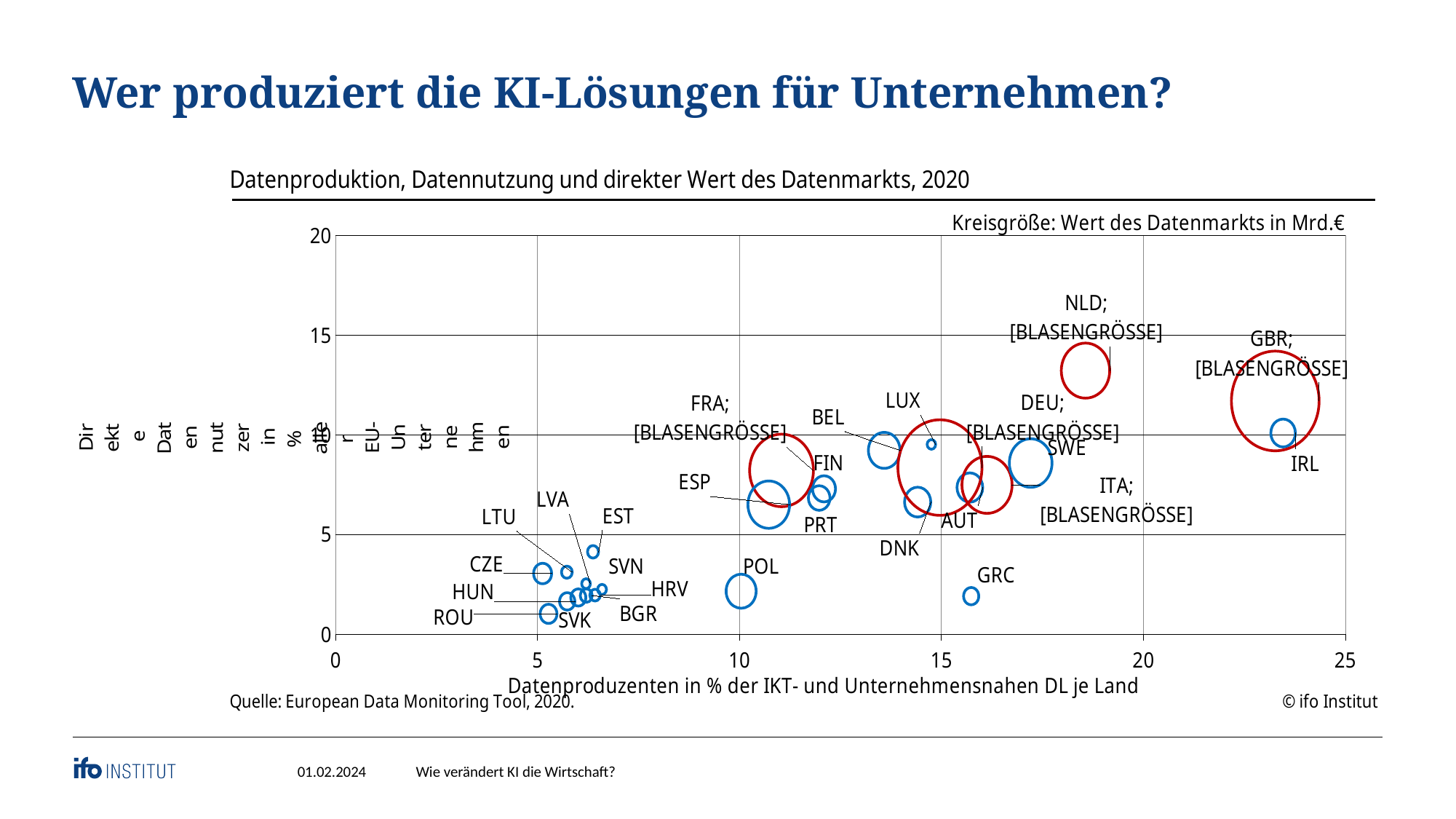
Is the x-axis value for BEL greater or less than 15? less Is the y-axis value for NLD greater or less than 10? greater According to the chart, what does the bubble size represent? Wert des Datenmarkts in Mrd.€ Which country has the higher x-axis value, GBR or GRC? GBR Which country has the largest bubble in the chart? GBR What kind of chart is shown on the slide? bubble chart Is the x-axis value for GBR greater or less than 20? greater What is the title of the chart? Datenproduktion, Datennutzung und direkter Wert des Datenmarkts, 2020